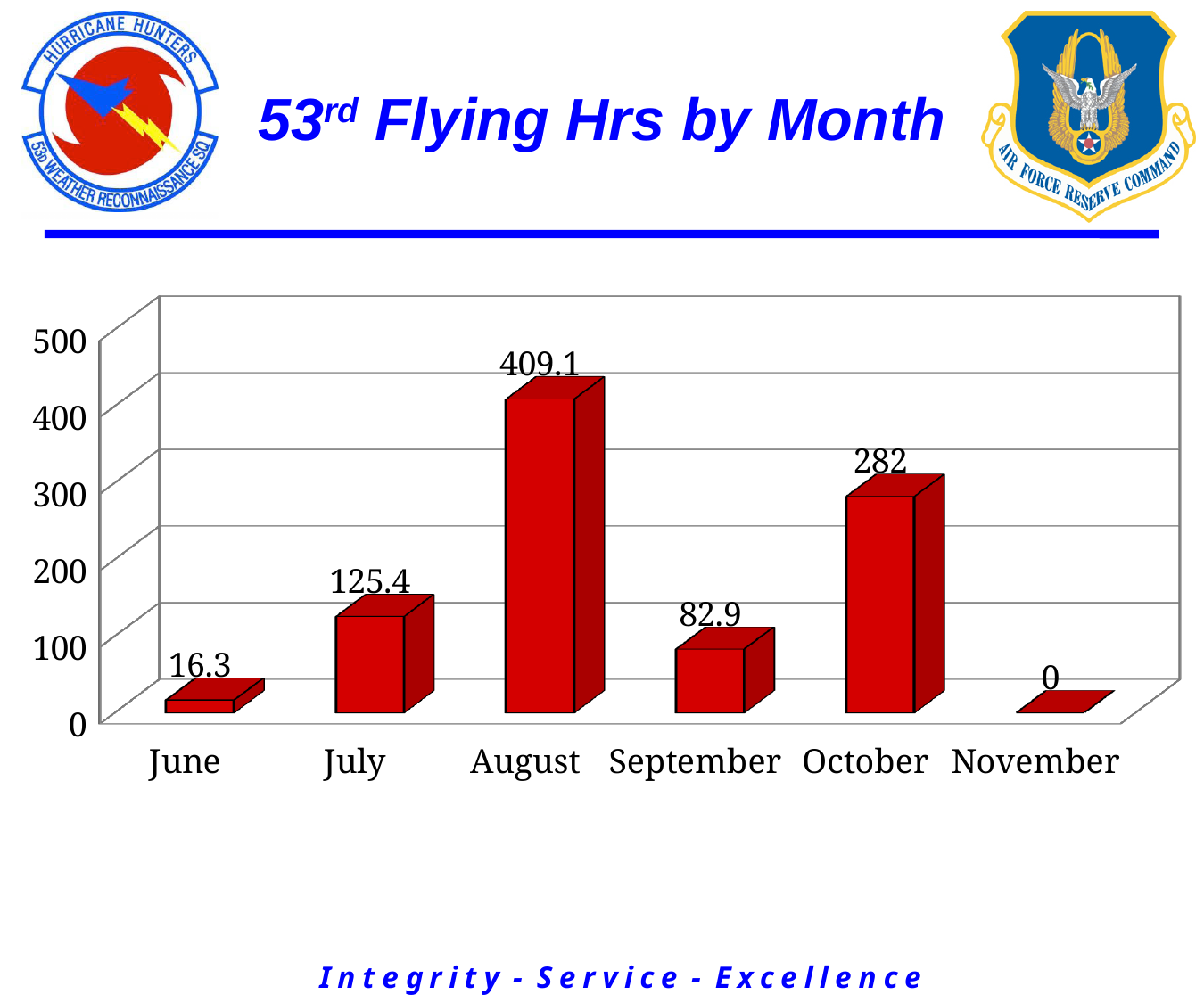
What is the value for November? 0 What is the value for July? 125.4 What is the title of the slide? 53rd Flying Hrs by Month What is the difference between the values for August and October? 127.1 What is the value for September? 82.9 How many months are shown on the x axis? 6 What is the value for August? 409.1 What kind of chart is shown on the slide? Bar chart Which is larger, the value for July or the value for September? July What is the difference between the values for July and June? 109.1 Which month has the highest value? August Which month has the lowest value? November